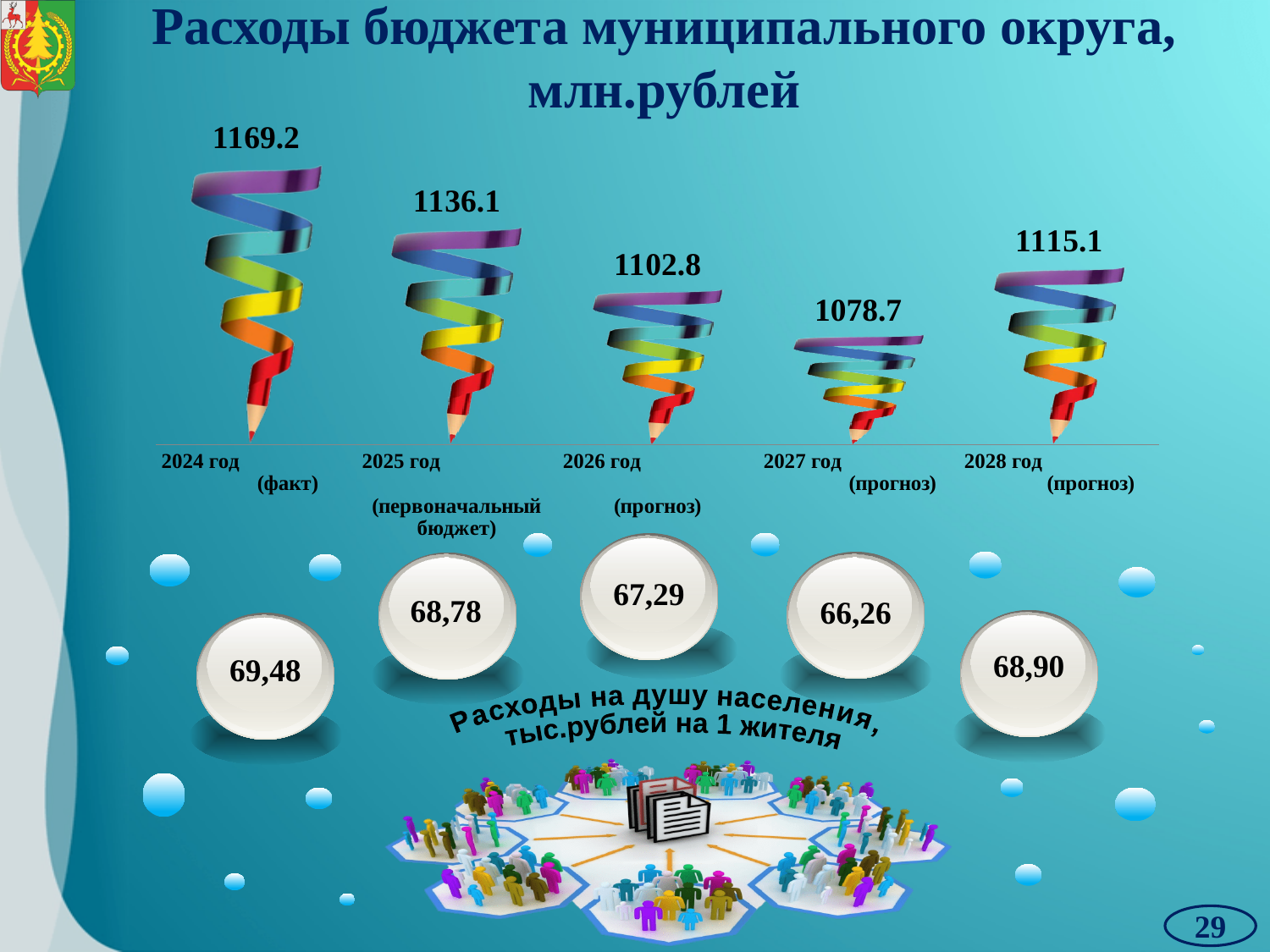
How do the budget expenditures change from 2024 to 2027? They fall What value is shown for 2028 (forecast) in the budget expenditures chart? 1115.1 Which is larger: the budget expenditures for 2025 or for 2028? 2025 год What is the difference between the budget expenditures for 2028 and 2027, in million rubles? 36.4 What is the title of the chart on the slide? Расходы бюджета муниципального округа, млн.рублей What are the budget expenditures of the municipal district for 2024 (fact), in million rubles? 1169.2 What value is shown for 2026 (forecast) in the budget expenditures chart? 1102.8 How many years are shown in the budget expenditures chart? 5 Which year has the lowest budget expenditures in the chart? 2027 год (прогноз) By how much do the budget expenditures for 2024 exceed those for 2025, in million rubles? 33.1 Which year has the highest budget expenditures in the chart? 2024 год (факт) What are the expenditures per capita (thousand rubles per resident) shown for 2026? 67,29